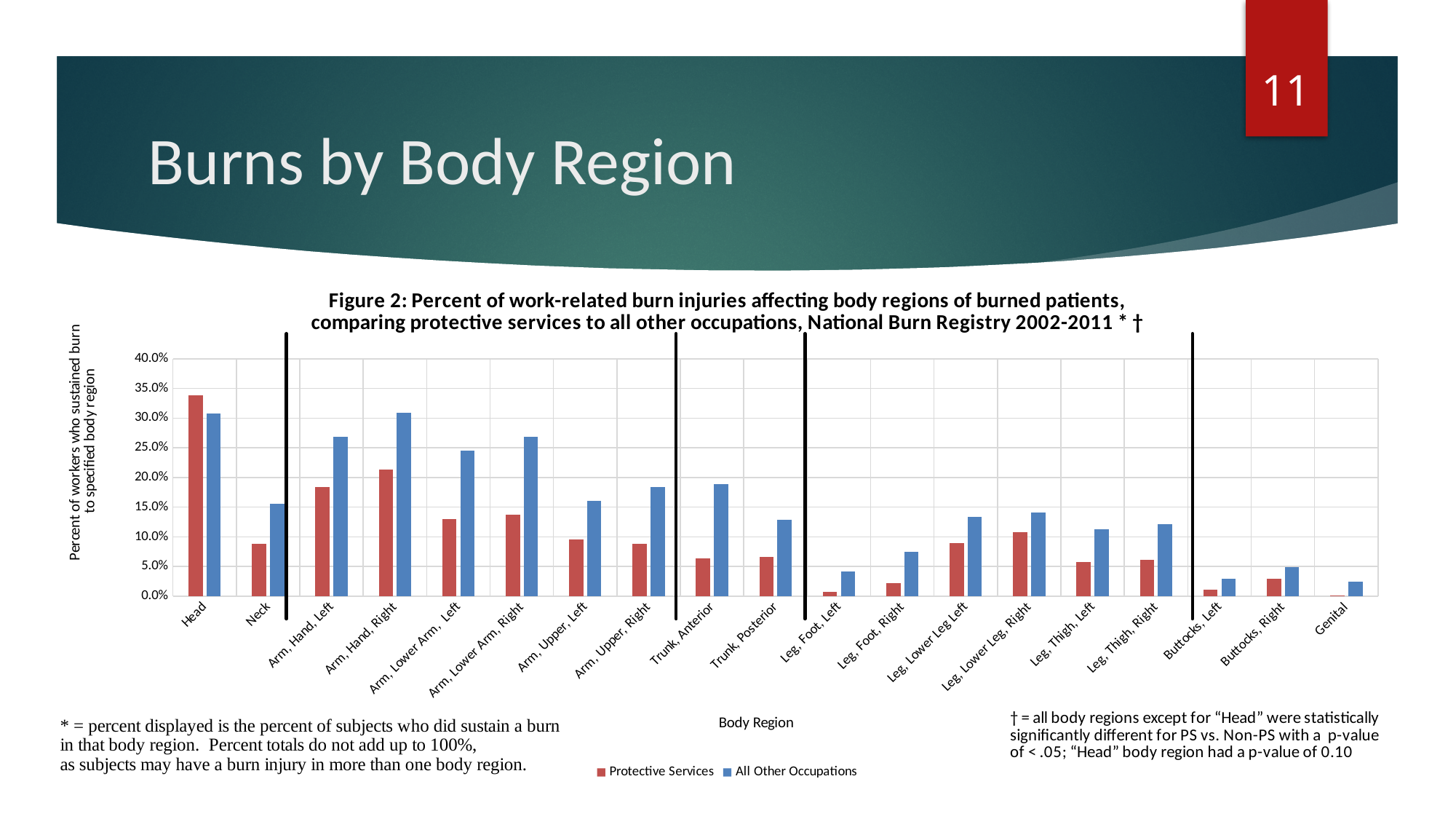
What colour are the bars for the All Other Occupations series? blue For Neck, which series has the larger value: Protective Services or All Other Occupations? All Other Occupations Is the Protective Services value for Neck greater or less than 10.0%? less Is the Protective Services value for Leg, Foot, Left greater or less than 5.0%? less Is the Protective Services value for Head greater or less than 30.0%? greater Which body region has the highest value for Protective Services? Head Which body region has the lowest value for Protective Services? Genital For Head, which series has the larger value: Protective Services or All Other Occupations? Protective Services What kind of chart is shown on the slide? bar chart How many series does the legend list? 2 How many body region categories are plotted on the x axis? 19